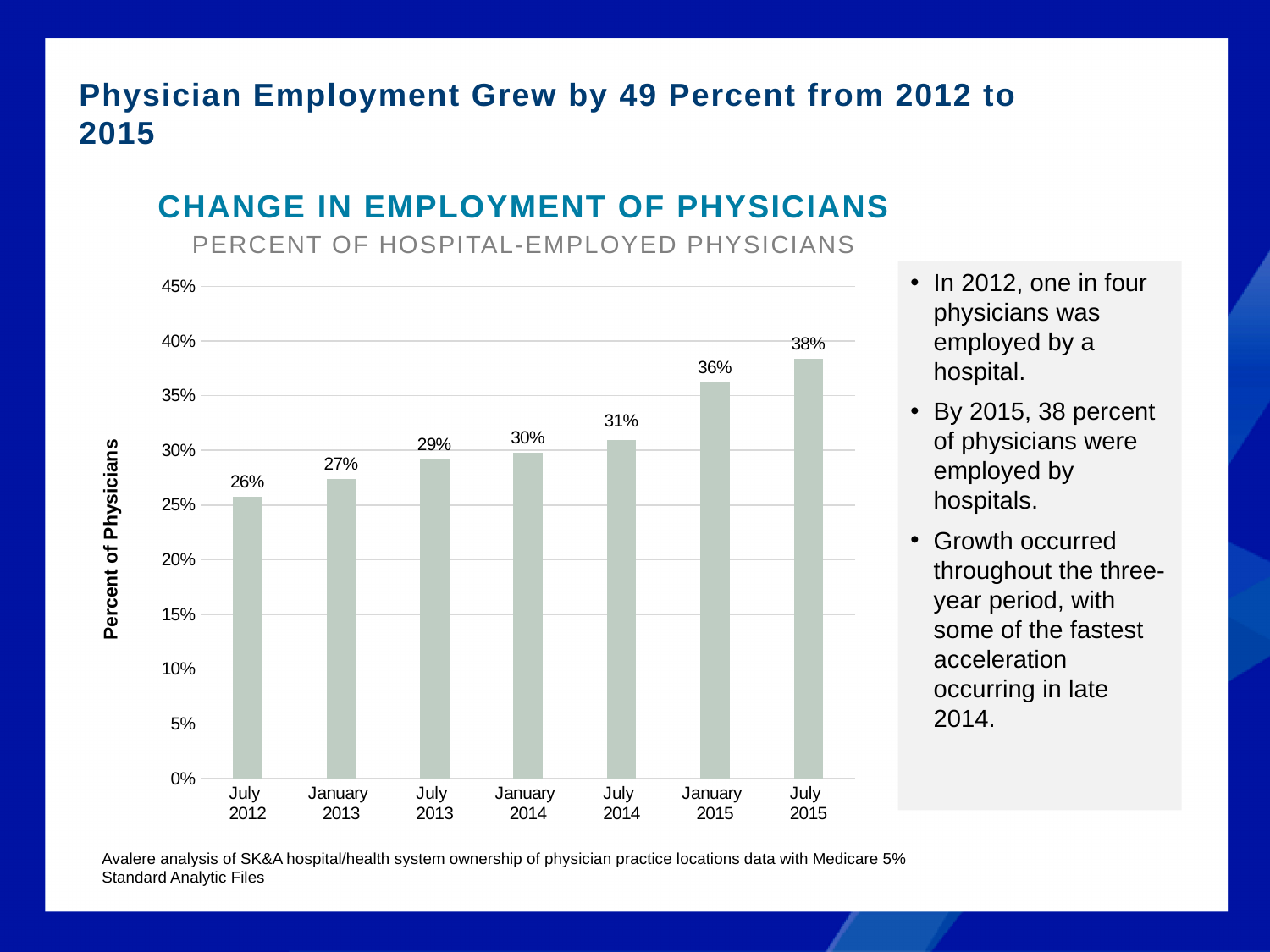
What is the label on the y axis of the chart? Percent of Physicians How many periods are shown on the x axis of the chart? 7 What is the percent of hospital-employed physicians in July 2015? 38% What is the percent of hospital-employed physicians in January 2014? 30% What kind of chart is shown on the slide? bar chart Which is larger, the value for July 2013 or the value for January 2015? January 2015 What is the difference in percentage points between January 2015 and July 2014? 5 What is the percent of hospital-employed physicians in July 2012? 26% Which period has the lowest percent of hospital-employed physicians? July 2012 What is the difference in percentage points between July 2015 and July 2012? 12 Which period has the highest percent of hospital-employed physicians? July 2015 Do the values rise or fall from July 2012 to July 2015? rise